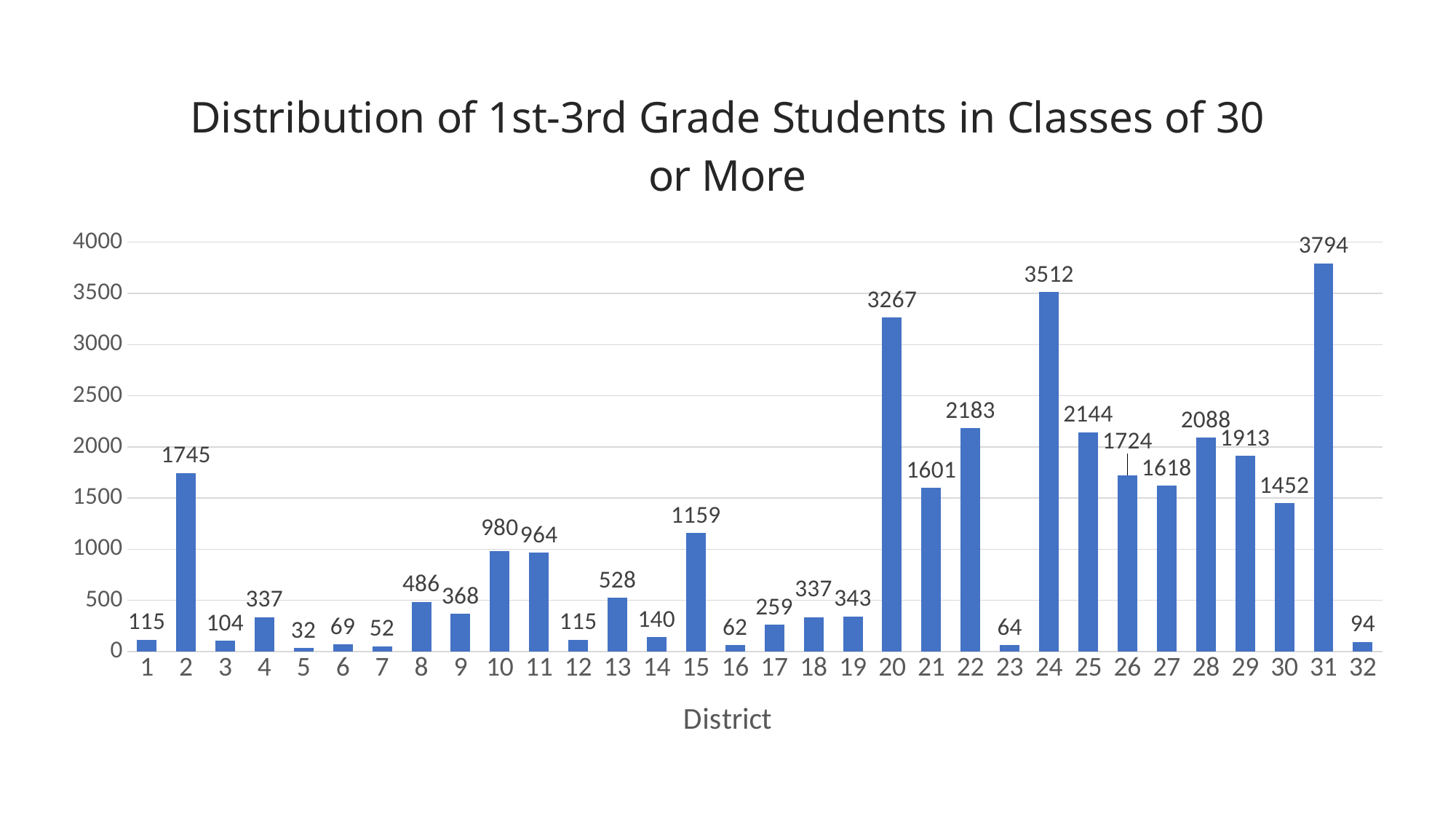
What kind of chart is this? Bar chart How many districts are shown on the x axis? 32 What is the label of the x axis? District Which district has the highest value? 31 What is the difference between the values for District 2 and District 30? 293 Which is larger, the value for District 22 or District 25? District 22 What is the difference between the values for District 24 and District 20? 245 Which district has the lowest value? 5 What is the value for District 31? 3794 What is the value for District 15? 1159 What is the title of the chart? Distribution of 1st-3rd Grade Students in Classes of 30 or More What is the value for District 5? 32